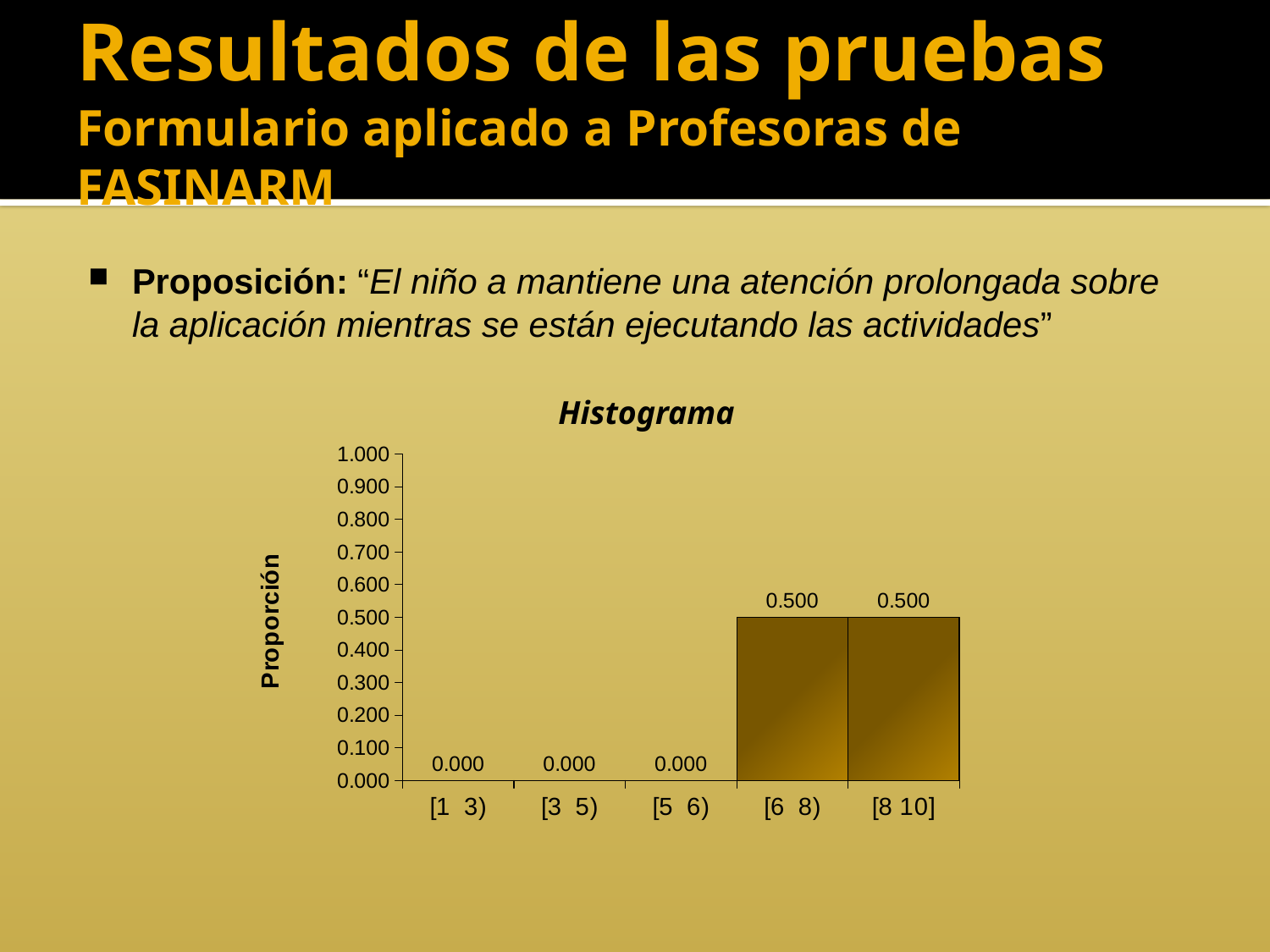
What is the value for the [5 6) bin in the Histograma chart? 0.000 Which is larger, the value for the [8 10] bin or the value for the [5 6) bin? [8 10] What is the value for the [6 8) bin in the Histograma chart? 0.500 What is the label of the vertical axis of the chart? Proporción What is the title of the chart on the slide? Histograma What is the difference between the values for the [6 8) bin and the [3 5) bin? 0.500 Is the value for the [6 8) bin greater or less than 0.400? greater What is the value for the [8 10] bin in the Histograma chart? 0.500 What kind of chart is shown on the slide? bar chart What is the value for the [1 3) bin in the Histograma chart? 0.000 What is the sum of the values for the [6 8) and [8 10] bins? 1.000 How many bins are shown on the x axis of the Histograma chart? 5